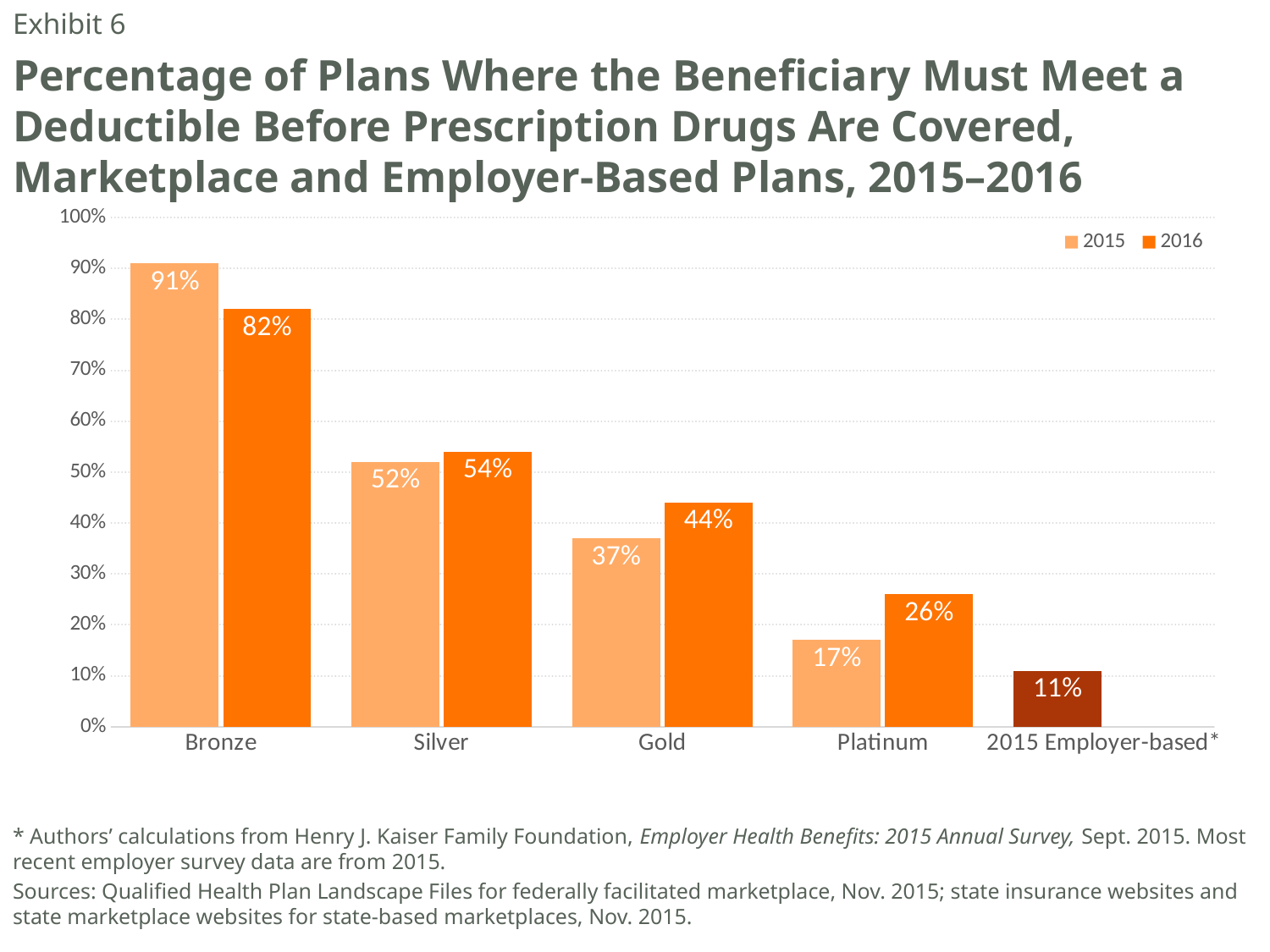
Do the 2016 values rise or fall from Bronze to Platinum? Fall What is the value shown for 2015 Employer-based plans? 11% What is the 2015 value for Bronze plans? 91% How many series does the legend list? 2 What kind of chart is shown on the slide? Bar chart Which marketplace plan tier has the lowest 2015 value? Platinum What is the difference between the 2015 and 2016 values for Gold plans? 7% Which is larger for Silver plans, the 2015 value or the 2016 value? 2016 What is the difference between the 2015 and 2016 values for Bronze plans? 9% What is the 2016 value for Platinum plans? 26% How many categories are shown on the x axis? 5 Which category has the highest 2016 value? Bronze